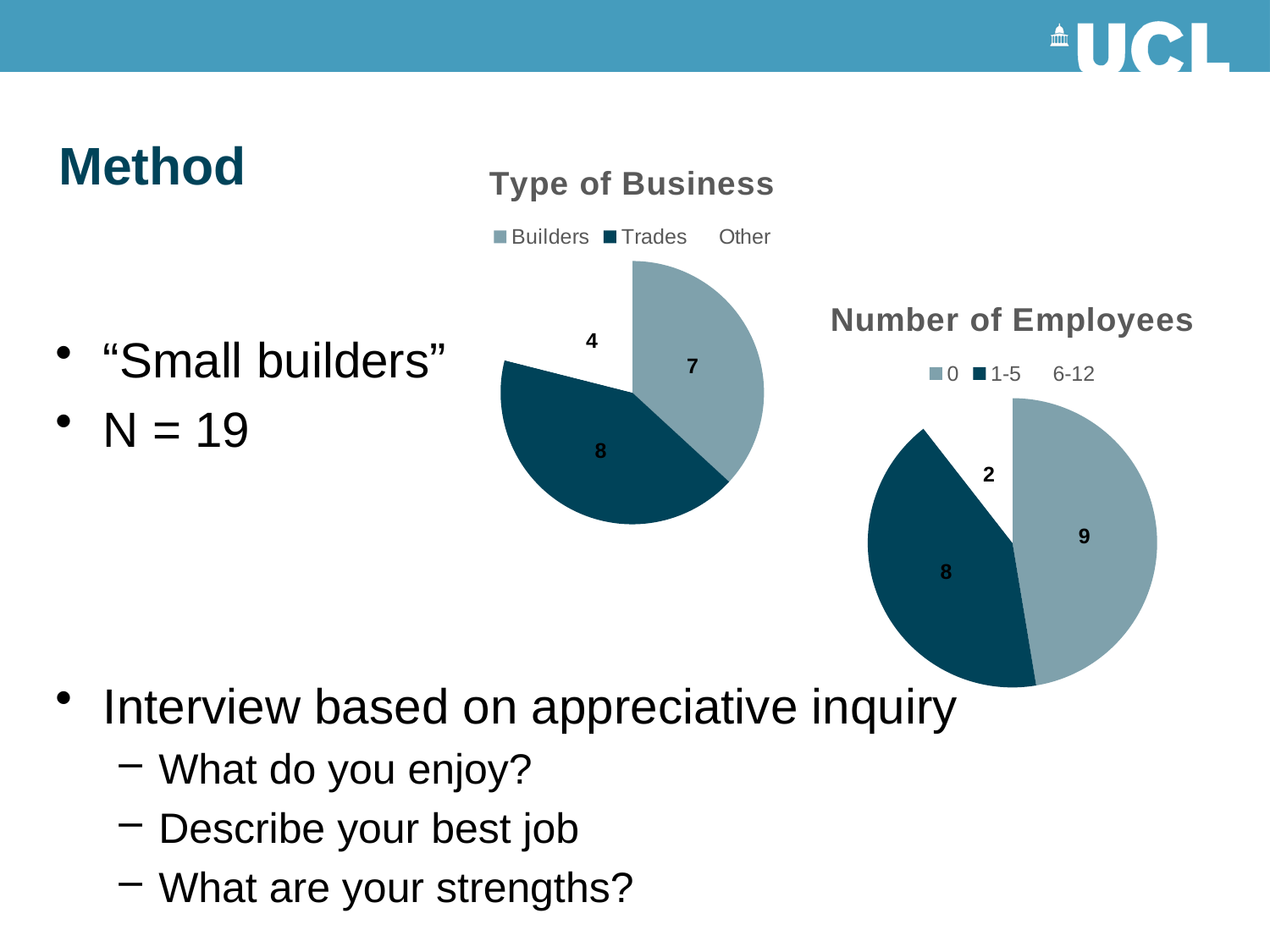
In the 'Number of Employees' chart, which category has the highest value? 0 In the 'Type of Business' chart, what is the value for Trades? 8 In the 'Type of Business' chart, how many categories does the legend list? 3 In the 'Number of Employees' chart, what is the value for the 0 category? 9 In the 'Number of Employees' chart, what is the value for the 6-12 category? 2 What kind of chart is the 'Type of Business' chart? Pie chart In the 'Number of Employees' chart, which is larger: the value for 1-5 or the value for 6-12? 1-5 In the 'Type of Business' chart, what is the value for Builders? 7 What is the title of the pie chart on the right side of the slide? Number of Employees In the 'Type of Business' chart, what is the difference between the Trades and Other values? 4 In the 'Number of Employees' chart, what is the difference between the 0 and 6-12 values? 7 In the 'Type of Business' chart, which category has the lowest value? Other